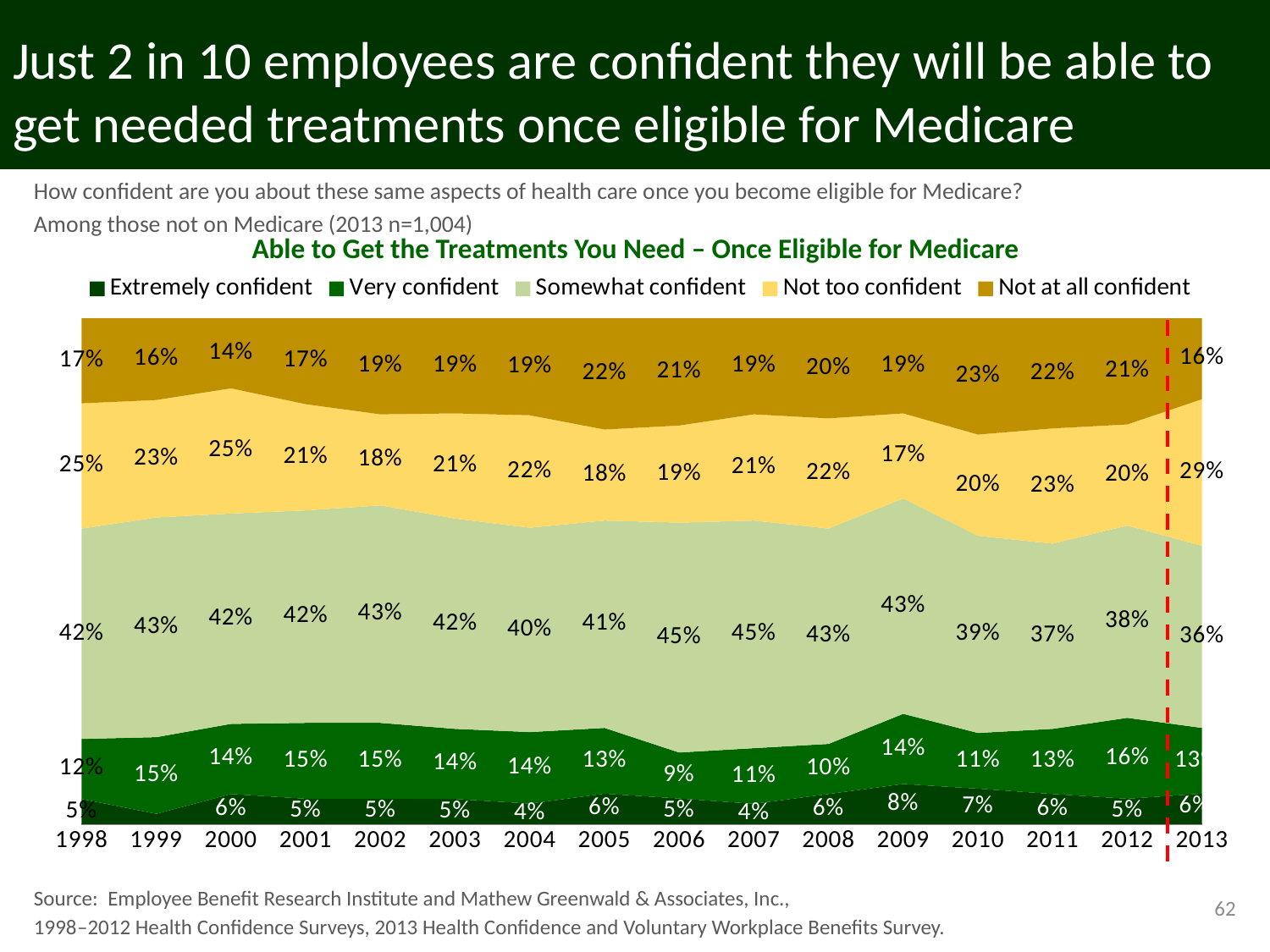
How many years are shown along the x axis? 16 In which year was the 'Very confident' share lowest? 2006 Which was larger in 2013, the 'Not too confident' share or the 'Not at all confident' share? Not too confident What percentage of respondents were 'Somewhat confident' in 2006? 45% In which year was the 'Somewhat confident' share lowest? 2013 What percentage of respondents were 'Not too confident' in 2013? 29% What is the title of the chart? Able to Get the Treatments You Need – Once Eligible for Medicare How many series does the legend list? 5 What is the difference between the 'Not too confident' share in 2013 and in 2012? 9 percentage points What percentage of respondents were 'Not at all confident' in 2010? 23% What percentage of respondents were 'Extremely confident' in 2009? 8% What type of chart is shown on the slide? Stacked area chart